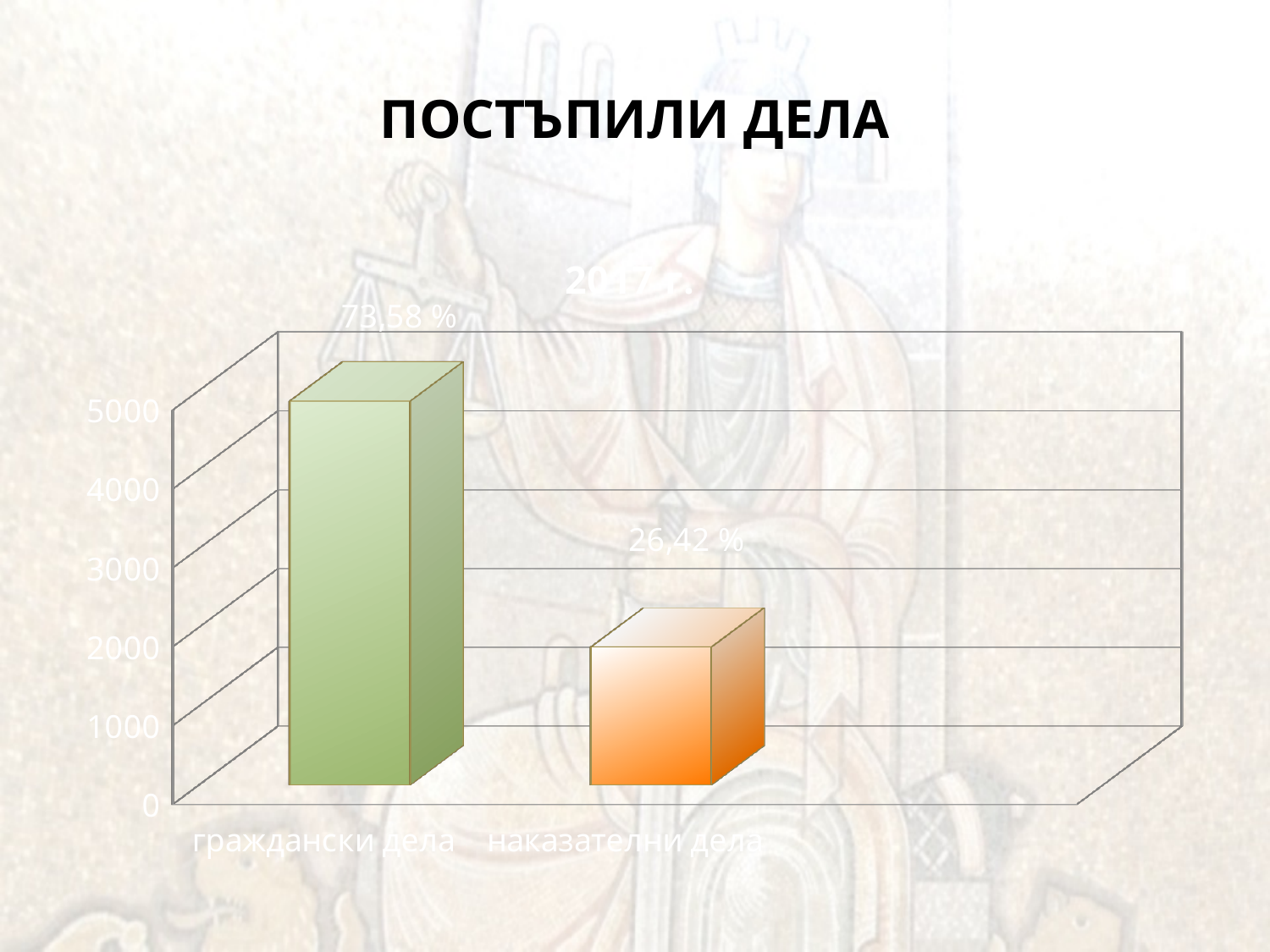
Is the value for наказателни дела greater or less than 1000? greater Is the value for наказателни дела greater or less than 3000? less Which category has the lowest bar? наказателни дела What data label is shown above the bar for наказателни дела? 26,42 % What is the title of the slide? ПОСТЪПИЛИ ДЕЛА What data label is shown above the bar for граждански дела? 73,58 % What kind of chart is shown on the slide? bar chart Is the value for граждански дела greater or less than 3000? greater Which is larger, the bar for граждански дела or the bar for наказателни дела? граждански дела Which category has the highest bar? граждански дела What is the title of the chart? 2017 г. How many categories are shown on the chart? 2